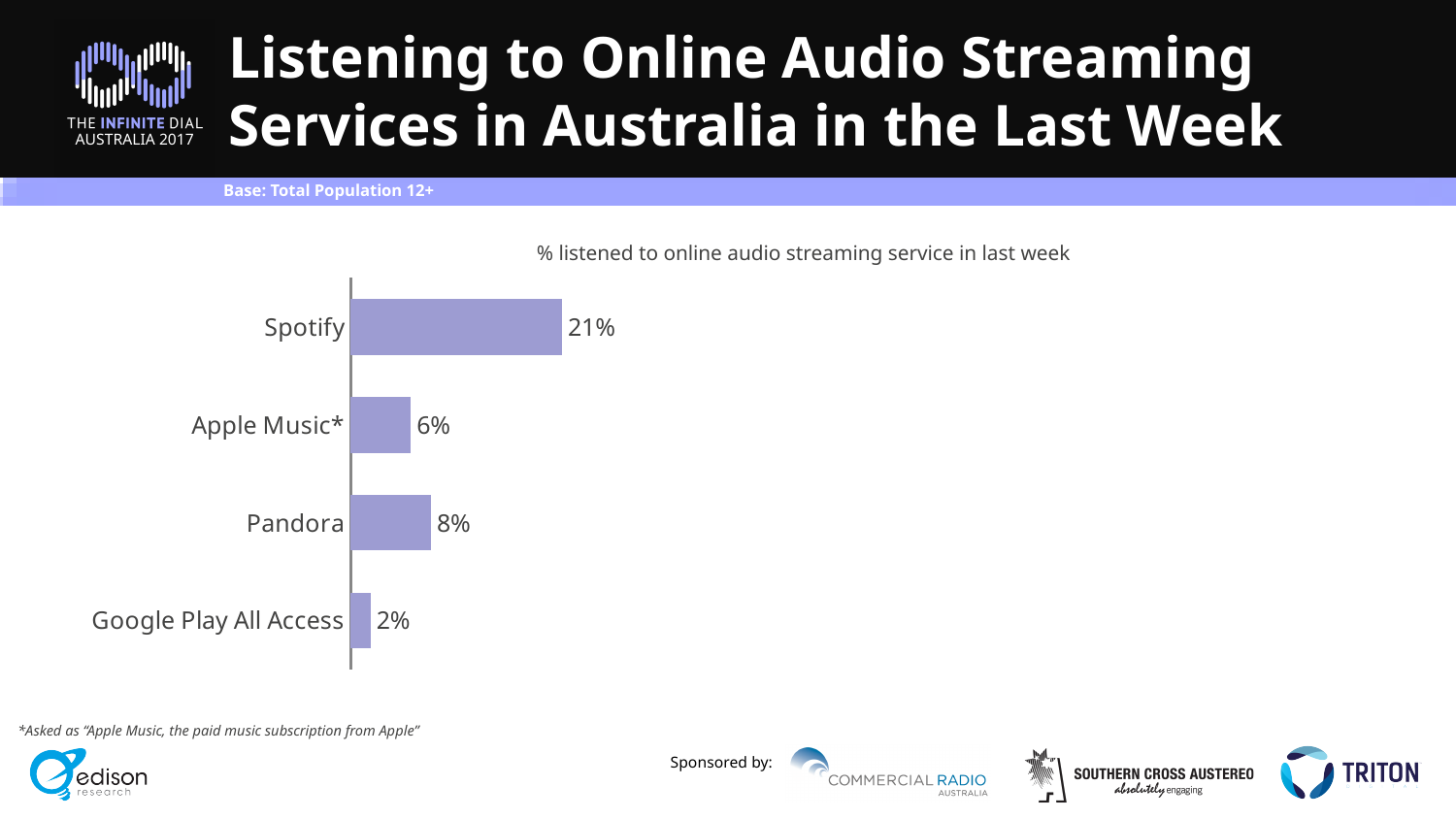
What is the value shown for Apple Music*? 6% Which has a larger value, Apple Music* or Pandora? Pandora What is the difference between the values for Spotify and Pandora? 13% What is the difference between the values for Pandora and Apple Music*? 2% What is the value for Google Play All Access? 2% Which service has the lowest percentage of listeners in the last week? Google Play All Access What type of chart is shown on the slide? Bar chart What percentage is shown for Pandora? 8% Which service has the highest percentage of listeners in the last week? Spotify How many services are shown in the chart? 4 What is the chart's title? % listened to online audio streaming service in last week What percentage listened to Spotify in the last week? 21%